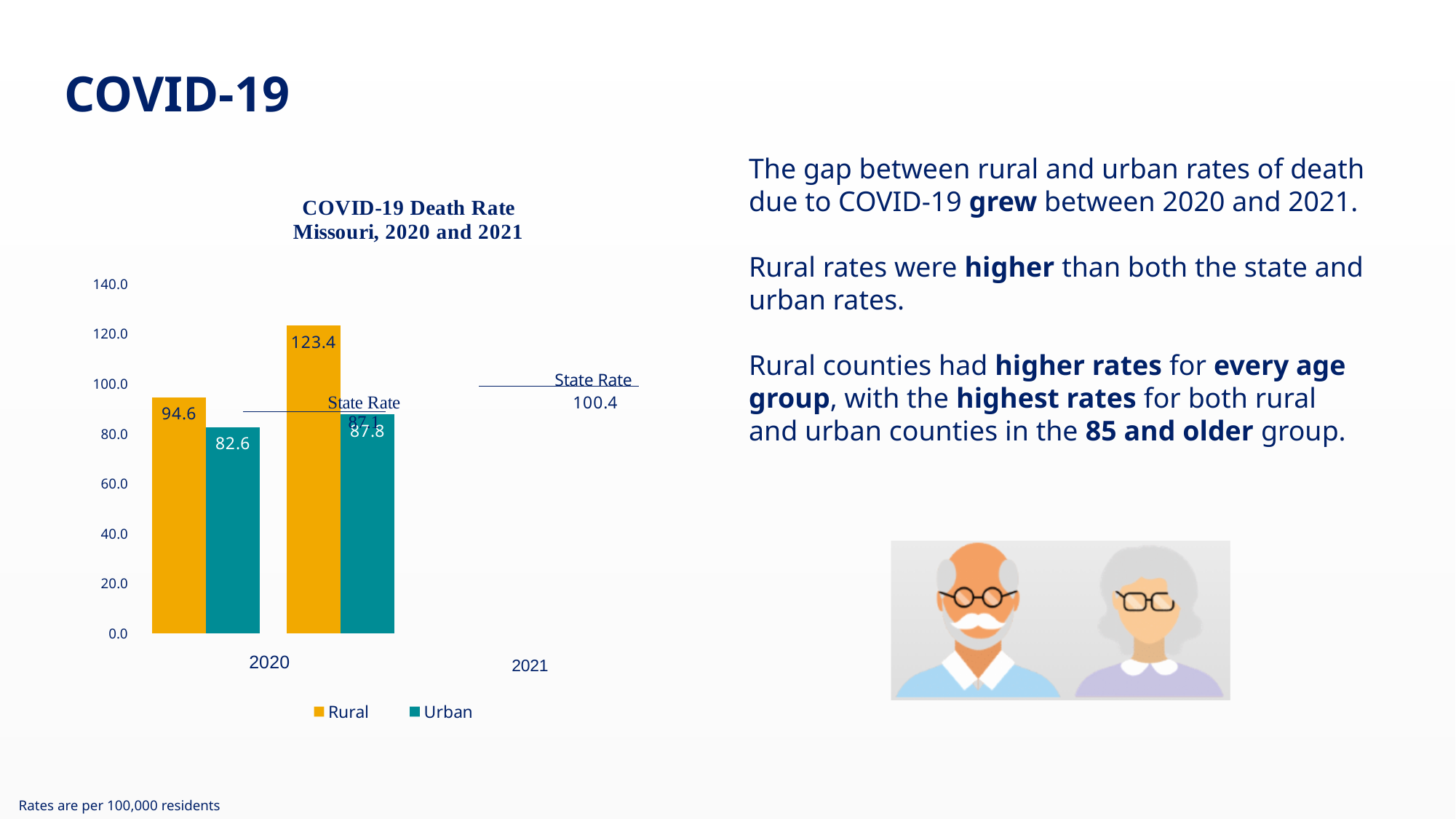
What is the urban COVID-19 death rate for 2021? 87.8 How many series does the legend list? 2 What type of chart is shown on the slide? Bar chart By how much did the rural death rate increase from 2020 to 2021? 28.8 What is the rural COVID-19 death rate for 2020? 94.6 What is the rural COVID-19 death rate for 2021? 123.4 What is the difference between the rural and urban death rates in 2021? 35.6 Which was higher in 2020, the rural rate or the urban rate? Rural What is the state rate shown for 2021? 100.4 What is the urban COVID-19 death rate for 2020? 82.6 Which bar has the highest value in the chart? Rural 2021 Which bar has the lowest value in the chart? Urban 2020